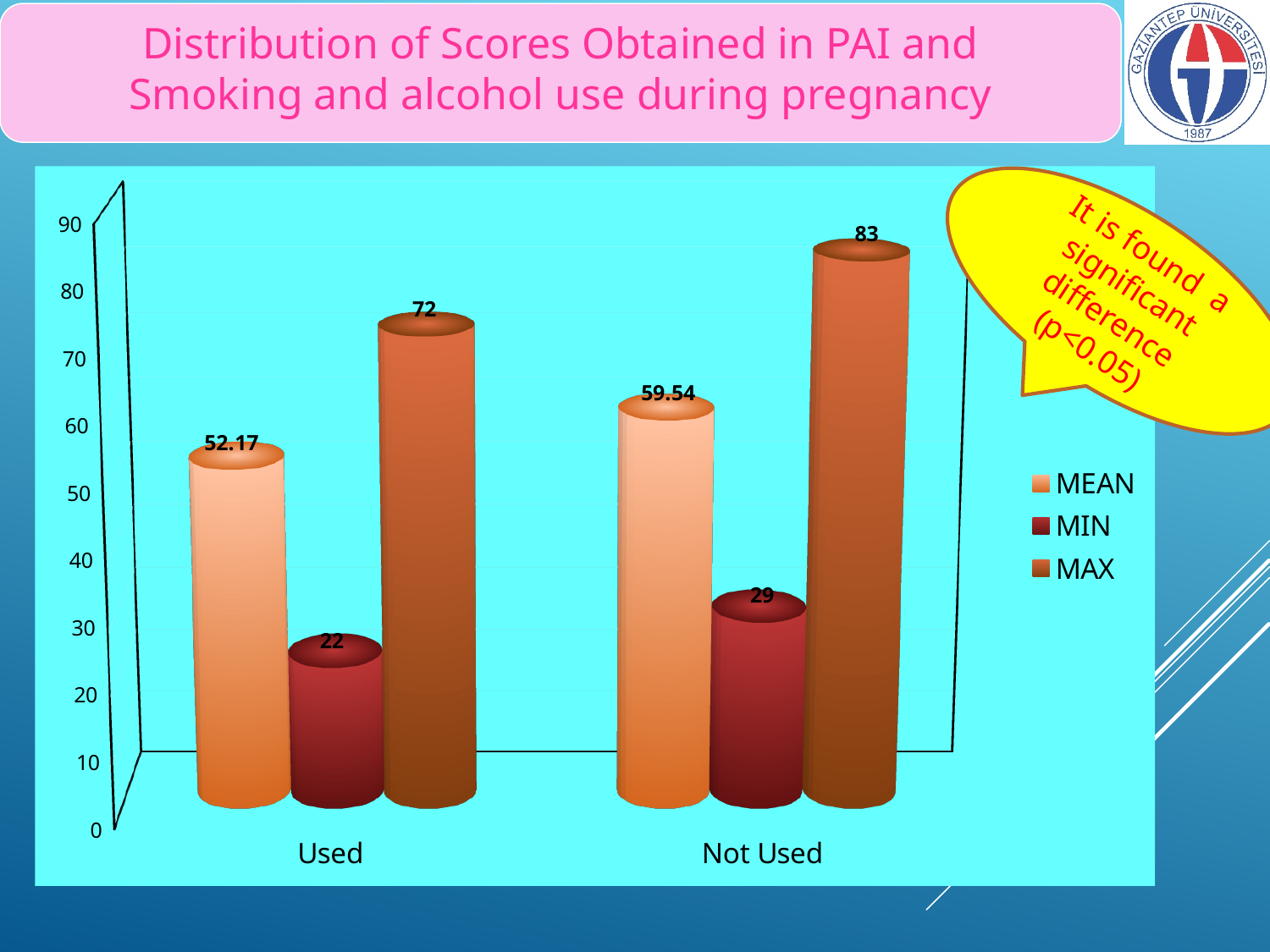
How many categories are shown on the x axis? 2 Which category has the higher MAX value? Not Used What is the MEAN value for the Used category? 52.17 What is the MEAN value for the Not Used category? 59.54 What is the difference between the MAX values for Not Used and Used? 11 What kind of chart is shown on the slide? bar chart Which category has the lower MIN value? Used What is the difference between the MIN values for Not Used and Used? 7 Is the MEAN value for Used larger or smaller than the MEAN value for Not Used? smaller How many series does the legend list? 3 What is the MIN value for the Used category? 22 What is the MAX value for the Not Used category? 83